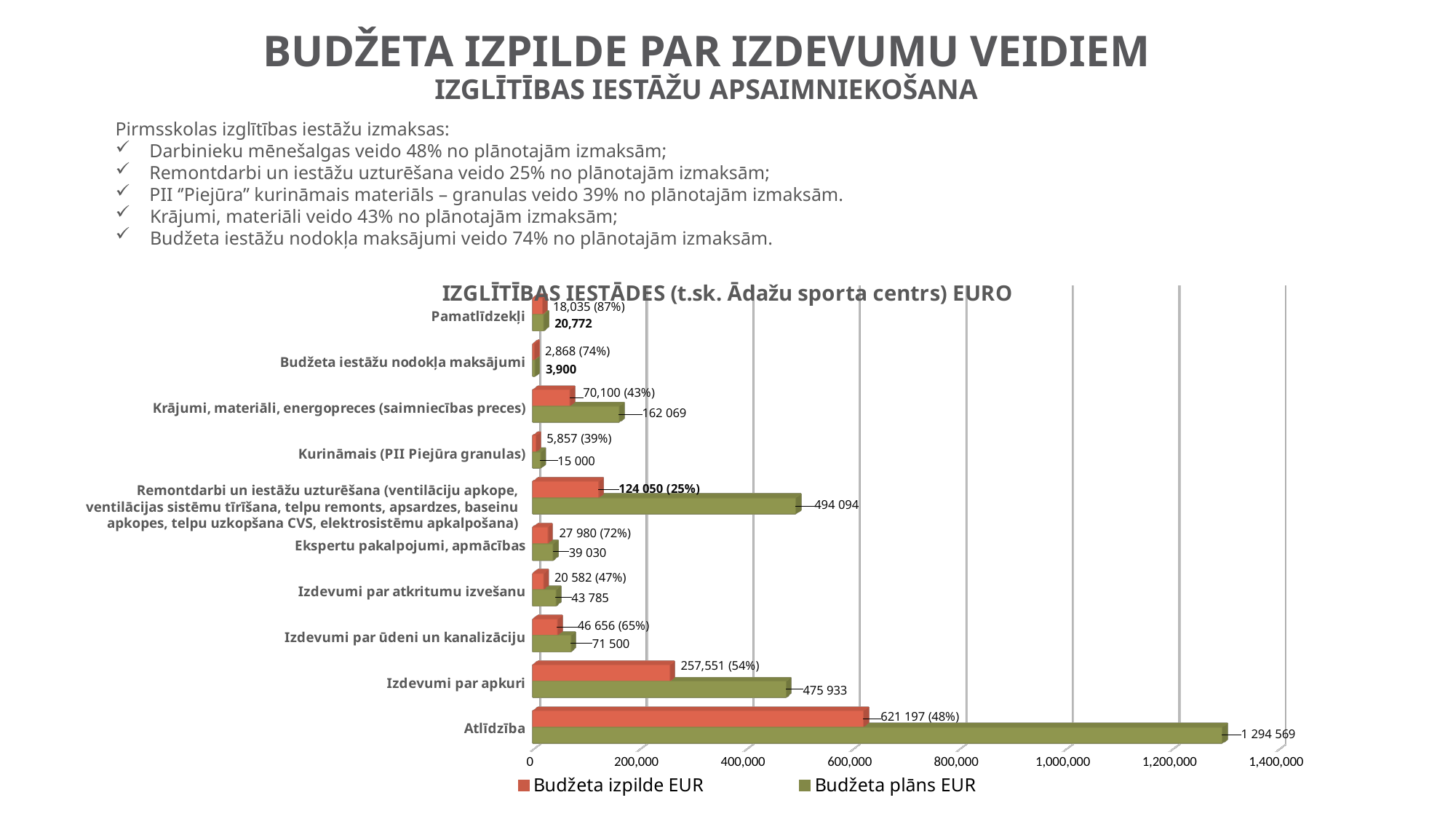
Which category has the lowest Budžeta izpilde EUR value? Budžeta iestāžu nodokļa maksājumi How many categories are shown on the chart? 10 What is the difference between the Budžeta plāns EUR and Budžeta izpilde EUR values for Izdevumi par apkuri? 218 382 Which is larger: the Budžeta plāns EUR value for Izdevumi par apkuri or for Remontdarbi un iestāžu uzturēšana? Remontdarbi un iestāžu uzturēšana What is the Budžeta plāns EUR value for Remontdarbi un iestāžu uzturēšana? 494 094 Which category has the highest Budžeta plāns EUR value? Atlīdzība How many series does the chart legend list? 2 What type of chart is shown on the slide? bar chart What is the Budžeta plāns EUR value for Atlīdzība? 1 294 569 What is the Budžeta izpilde EUR value for Izdevumi par apkuri? 257,551 Which series is shown in red on the chart? Budžeta izpilde EUR What percentage of the plan is shown next to the Budžeta izpilde EUR value for Kurināmais (PII Piejūra granulas)? 39%